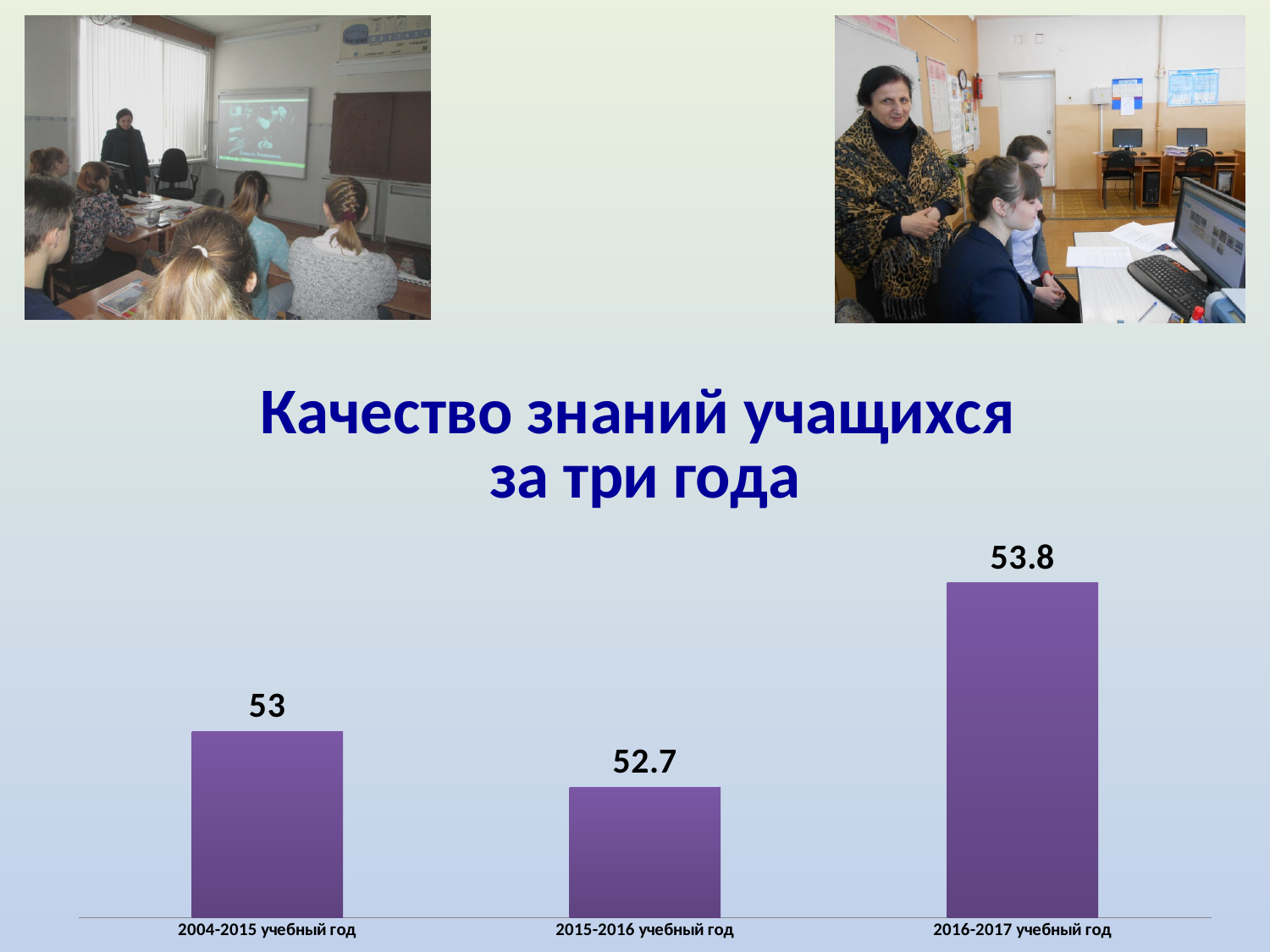
What is the difference between the values for 2016-2017 учебный год and 2015-2016 учебный год? 1.1 Which school year has the lowest value? 2015-2016 учебный год Which is larger, the value for 2004-2015 учебный год or for 2016-2017 учебный год? 2016-2017 учебный год What kind of chart is shown on the slide? bar chart What is the difference between the values for 2004-2015 учебный год and 2015-2016 учебный год? 0.3 Which school year has the highest value? 2016-2017 учебный год How many school years are shown in the chart? 3 What is the title of the chart? Качество знаний учащихся за три года What is the value for the 2004-2015 учебный год? 53 What colour are the bars in the chart? purple What is the value for the 2016-2017 учебный год? 53.8 What is the value for the 2015-2016 учебный год? 52.7